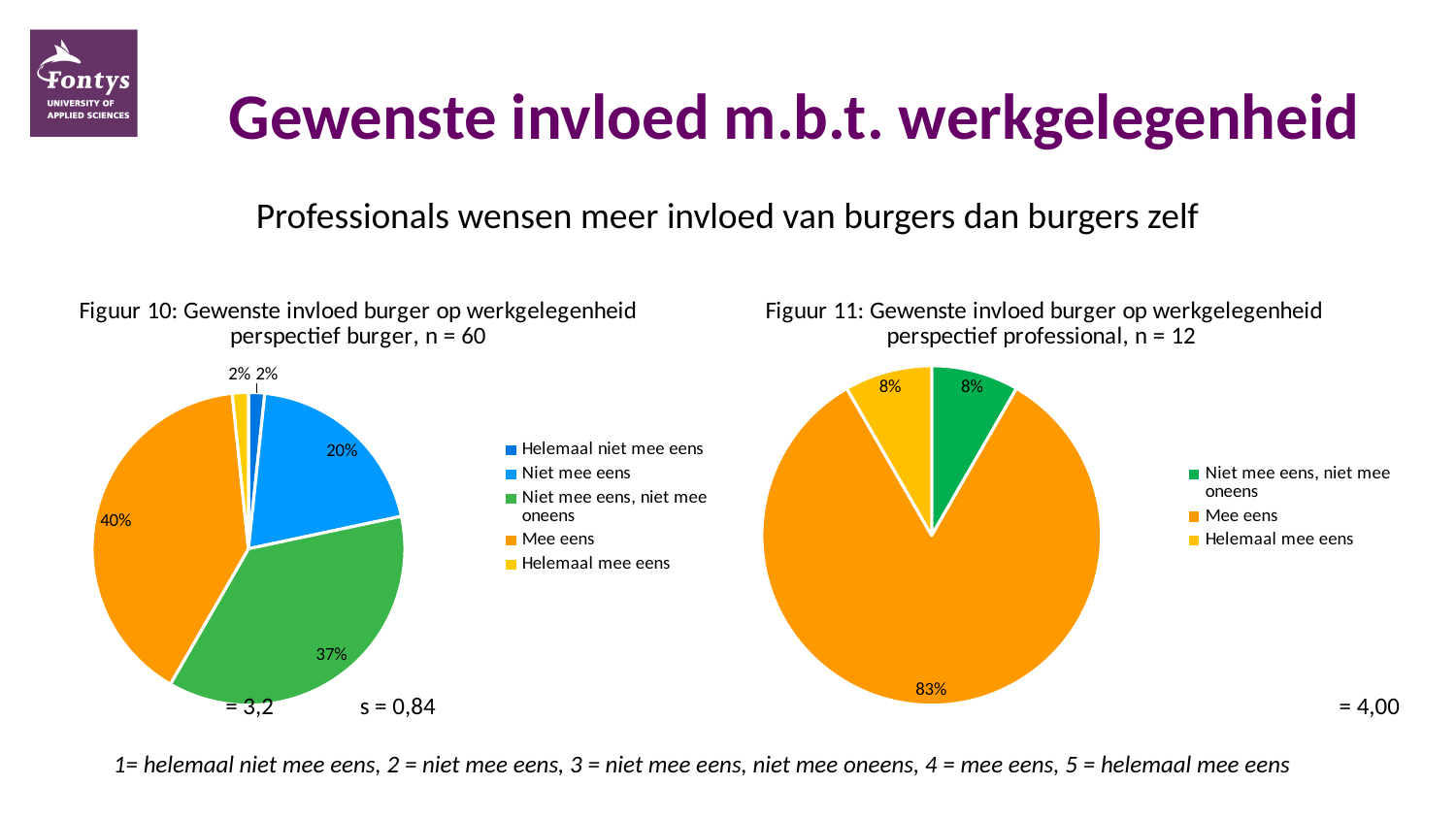
In Figuur 10 (perspectief burger), what is the difference in percentage points between 'Mee eens' and 'Niet mee eens'? 20 What type of chart is Figuur 10 (perspectief burger)? Pie chart In Figuur 11 (perspectief professional), what share of respondents answered 'Helemaal mee eens'? 8% In Figuur 11 (perspectief professional), what share of respondents answered 'Mee eens'? 83% Which is larger: the 'Mee eens' share in Figuur 10 (perspectief burger) or in Figuur 11 (perspectief professional)? Figuur 11 (perspectief professional) In Figuur 10 (perspectief burger), what share of respondents answered 'Niet mee eens, niet mee oneens'? 37% How many answer categories does the legend of Figuur 10 (perspectief burger) list? 5 In Figuur 10 (perspectief burger), which answer category has the largest share? Mee eens In Figuur 11 (perspectief professional), which answer category has the largest share? Mee eens How many answer categories does the legend of Figuur 11 (perspectief professional) list? 3 In Figuur 10 (perspectief burger), what share of respondents answered 'Niet mee eens'? 20% In Figuur 10 (perspectief burger), what share of respondents answered 'Mee eens'? 40%